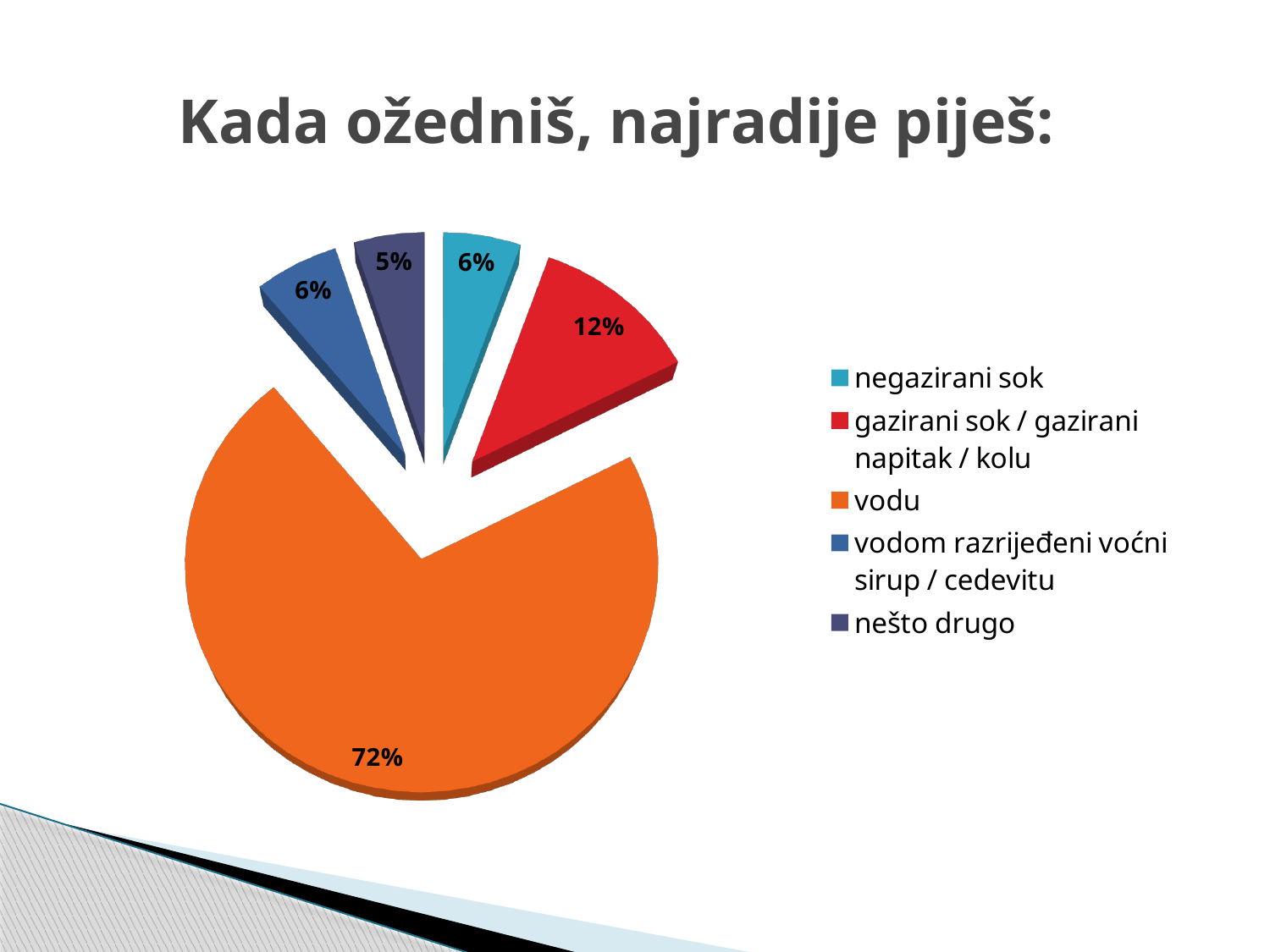
Which is larger: the share for "gazirani sok / gazirani napitak / kolu" or the share for "negazirani sok"? gazirani sok / gazirani napitak / kolu What is the difference between the share for "vodu" and the share for "gazirani sok / gazirani napitak / kolu"? 60% What is the value shown for "vodom razrijeđeni voćni sirup / cedevitu"? 6% What is the value shown for "nešto drugo"? 5% Which category has the largest slice of the pie? vodu Which category has the smallest slice of the pie? nešto drugo What share of the pie does "vodu" take? 72% What kind of chart is shown on the slide? pie chart How many categories does the pie chart show? 5 What is the value shown for "gazirani sok / gazirani napitak / kolu"? 12% What is the title of the slide? Kada ožedniš, najradije piješ: What is the value shown for "negazirani sok"? 6%